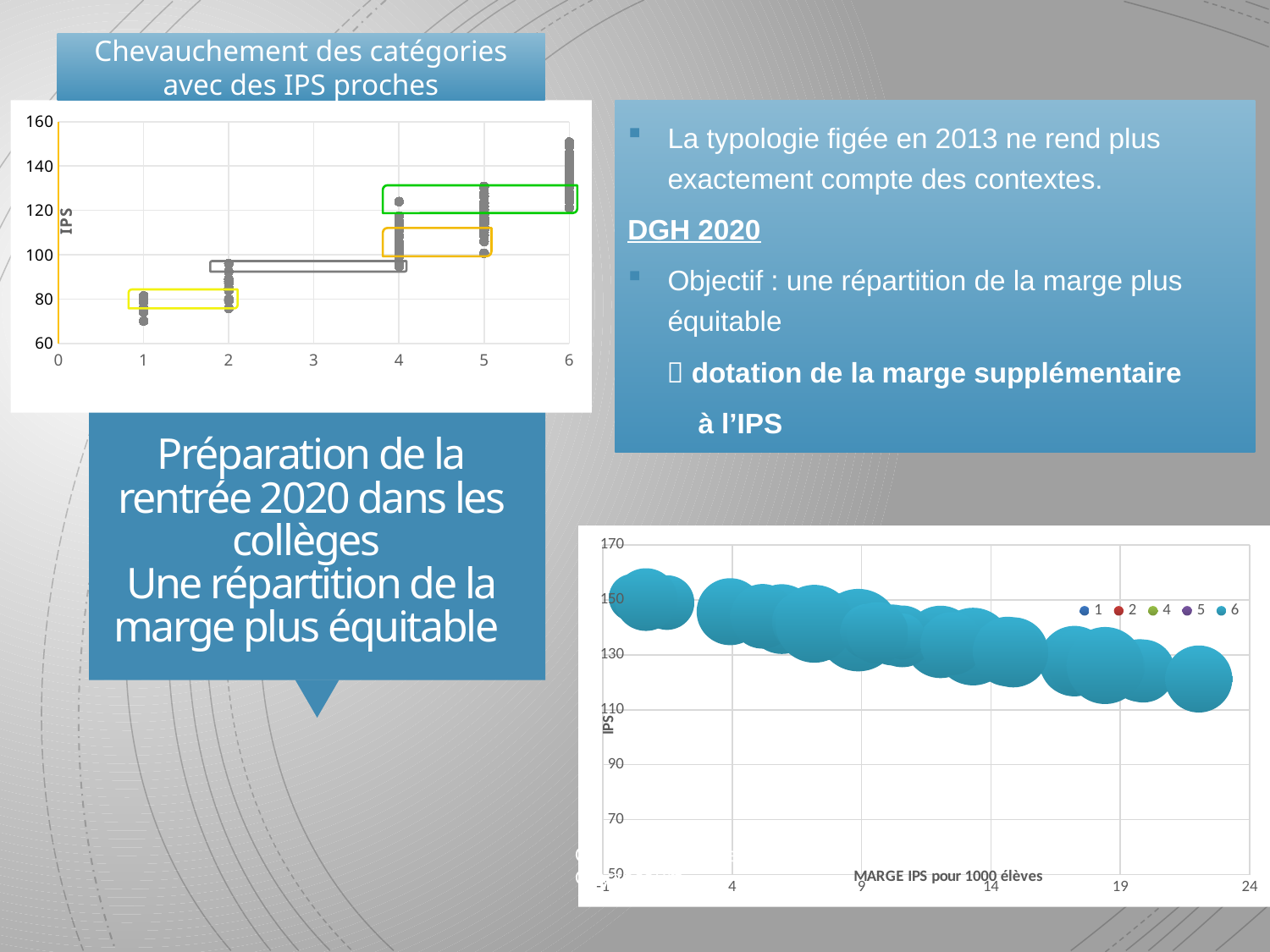
In the top-left chart, are the IPS values for category 2 greater or less than 100? less In the top-left chart, is the highest IPS value for category 6 greater or less than 140? greater In the top-left chart, what is the label of the y axis? IPS In the top-left chart, which x-axis category has the highest IPS values? 6 In the bottom-right chart, do the IPS values rise or fall as the marge per 1000 élèves increases? fall In the top-left chart, which x-axis category has the lowest IPS values? 1 In the bottom-right chart, how many series does the legend list? 5 What kind of chart is the bottom-right chart? bubble chart In the bottom-right chart, what is the title of the x axis? MARGE IPS pour 1000 élèves In the top-left chart, how many x-axis categories have plotted points? 5 What kind of chart is the top-left chart titled 'Chevauchement des catégories avec des IPS proches'? scatter chart In the top-left chart, are the IPS values for category 1 greater or less than 100? less